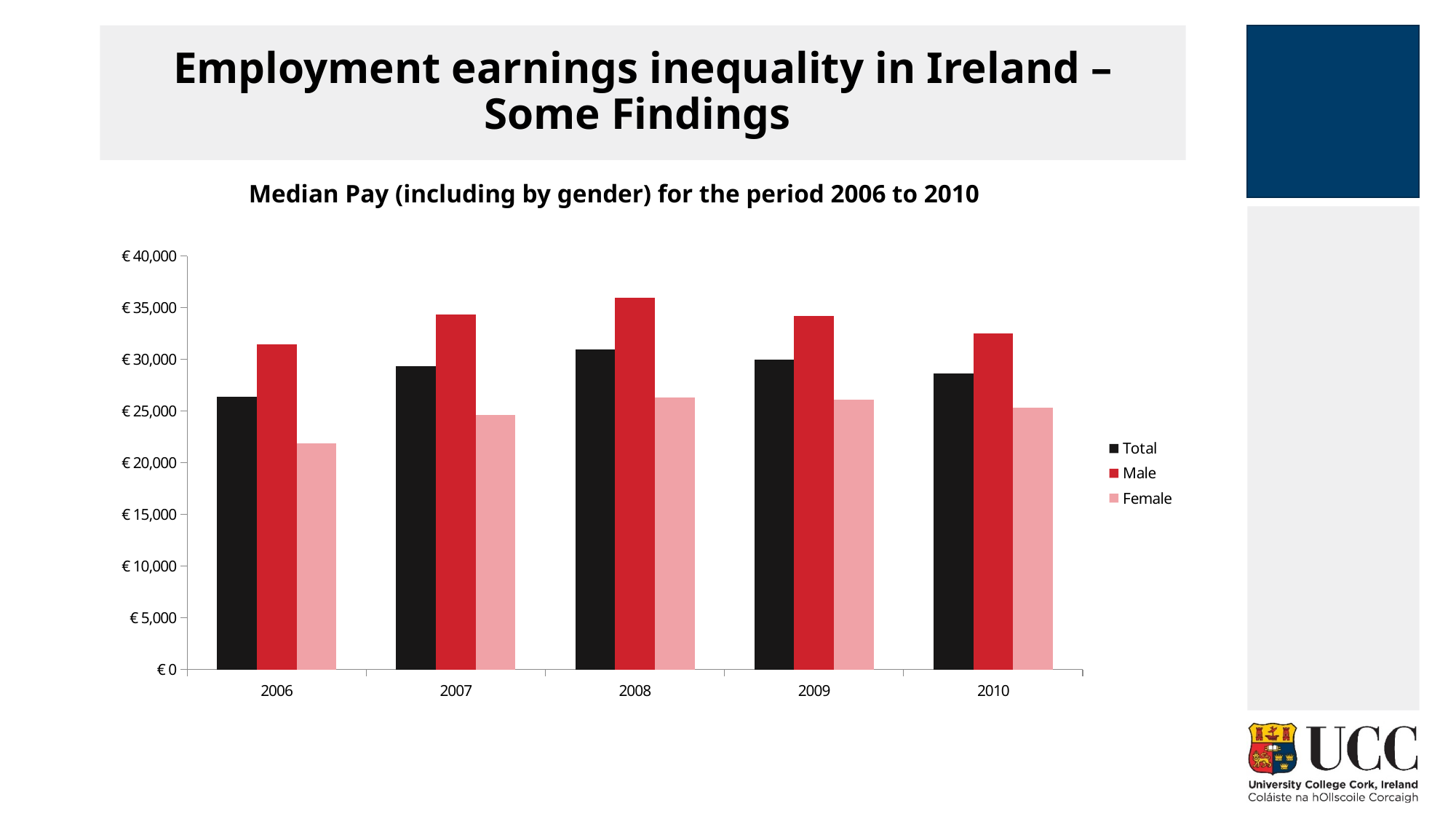
In which year is the Male median pay highest? 2008 Is the Male value for 2008 greater or less than €35,000? greater Is the Female value for 2006 greater or less than €25,000? less How many years are shown on the x axis? 5 What kind of chart is shown on the slide? Bar chart In 2008, which is larger, the Male or the Female median pay? Male How many series does the legend list? 3 Which series has the highest value in every year shown? Male In which year is the Female median pay lowest? 2006 Do the Male values rise or fall from 2008 to 2010? fall Is the Total value for 2006 greater or less than €30,000? less What is the title of the chart? Median Pay (including by gender) for the period 2006 to 2010